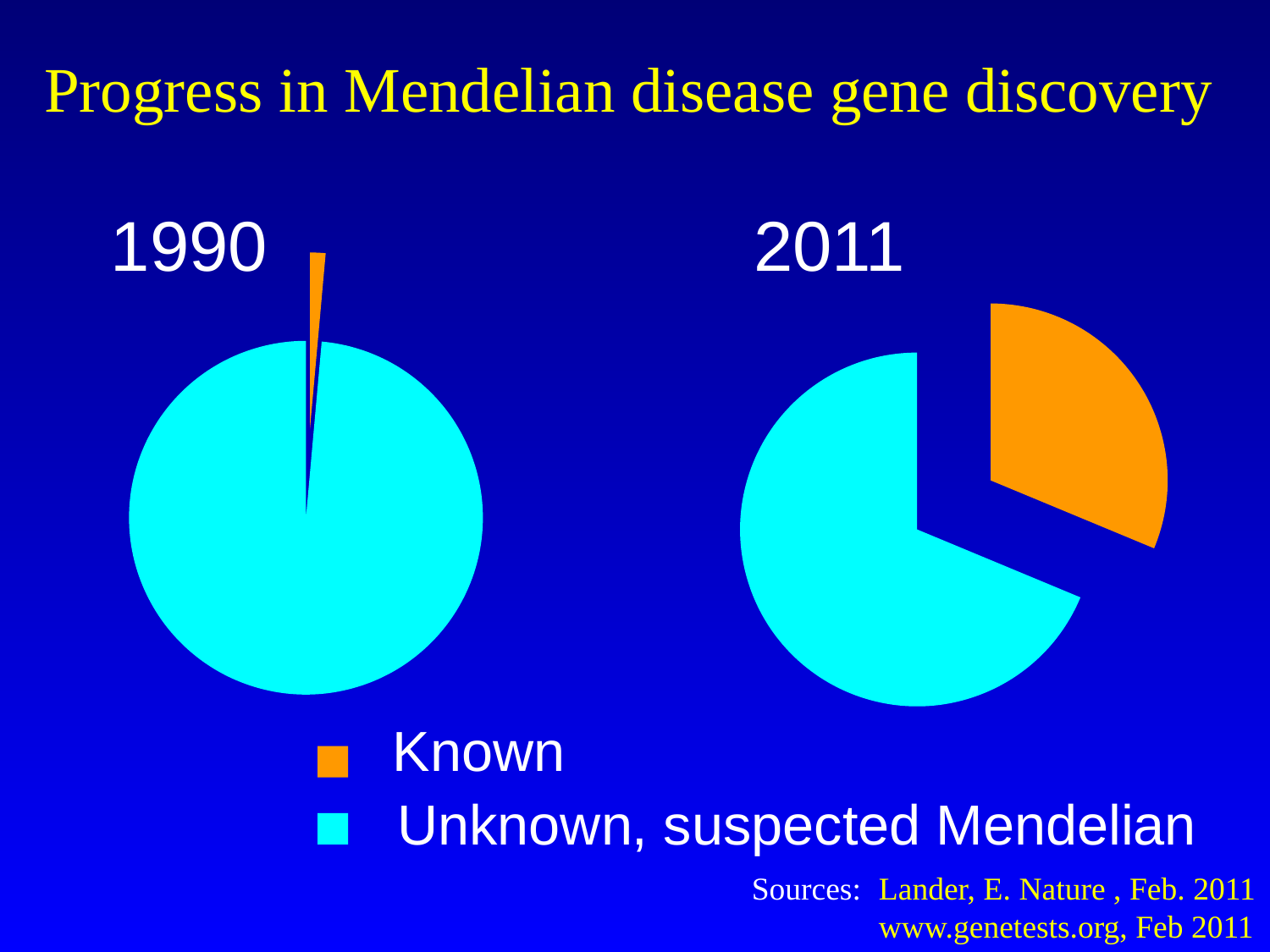
What kind of chart is the 2011 chart? Pie chart How many categories does the legend list? 2 In the 2011 pie chart, which category has the largest slice? Unknown, suspected Mendelian How many slices does the 1990 pie chart have? 2 In the 1990 pie chart, which category has the largest slice? Unknown, suspected Mendelian In the 1990 pie chart, which category has the smallest slice? Known What kind of chart is the 1990 chart? Pie chart What is the title of the slide containing the two pie charts? Progress in Mendelian disease gene discovery In the 2011 pie chart, which category has the smallest slice? Known What colour represents the Known category in the pie charts? Orange Is the Known slice larger in the 1990 pie chart or the 2011 pie chart? 2011 How many slices does the 2011 pie chart have? 2